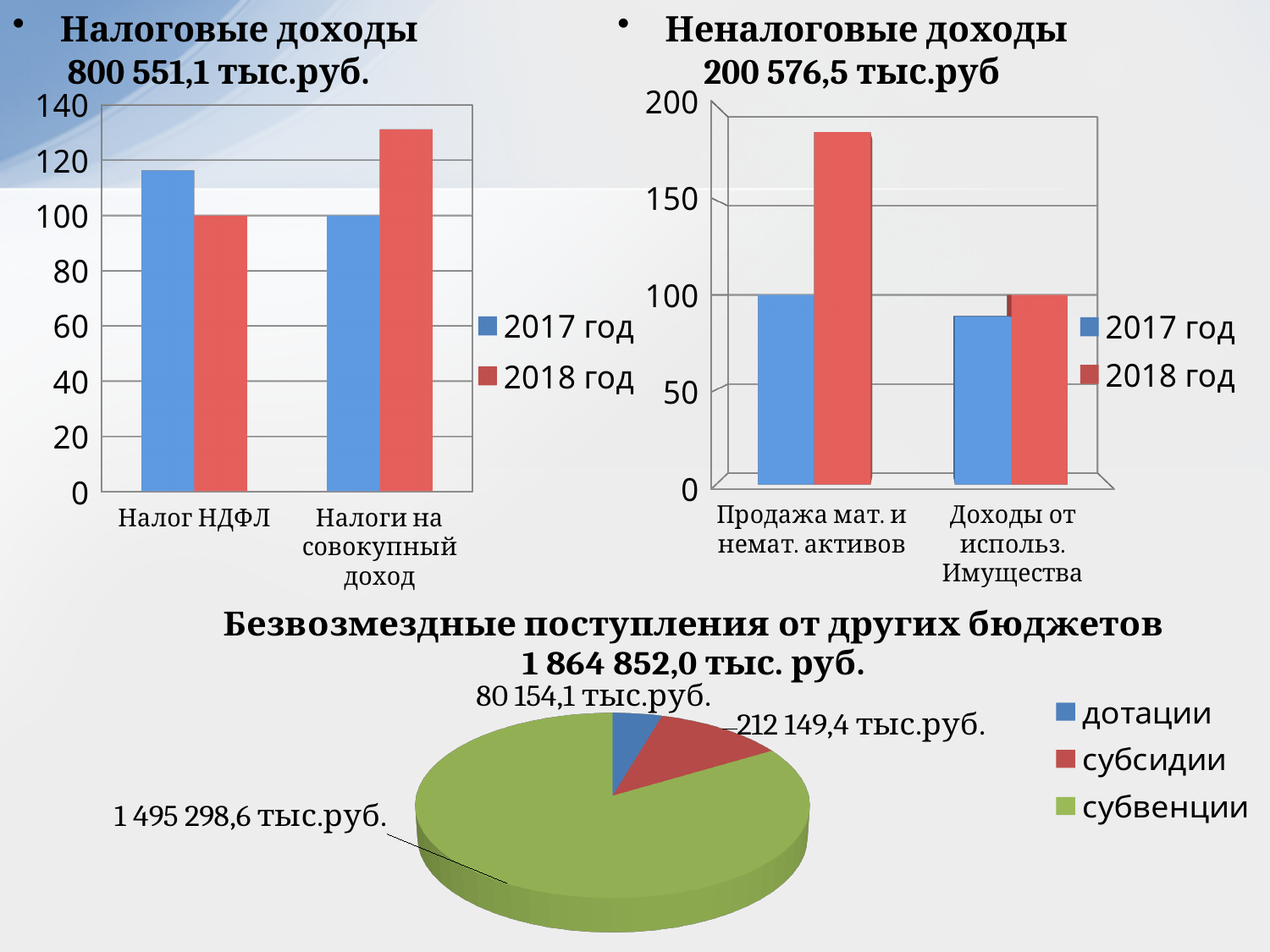
In the 'Неналоговые доходы' chart, is the value for 'Доходы от использ. Имущества' in 2017 год greater or less than 100? less In the 'Налоговые доходы' chart, what is the value for 'Налог НДФЛ' in 2018 год? 100 How many series does the legend of the 'Неналоговые доходы' chart list? 2 What type of chart is the 'Налоговые доходы' chart? bar chart In the 'Налоговые доходы' chart, which series is larger for 'Налог НДФЛ', 2017 год or 2018 год? 2017 год What type of chart is the 'Безвозмездные поступления от других бюджетов' chart? pie chart In the 'Безвозмездные поступления от других бюджетов' pie chart, what is the value for 'субсидии'? 212 149,4 тыс.руб. In the 'Налоговые доходы' chart, is the value for 'Налоги на совокупный доход' in 2018 год greater or less than 120? greater In the 'Безвозмездные поступления от других бюджетов' pie chart, what is the difference between the 'субсидии' and 'дотации' values? 131 995,3 тыс.руб. In the 'Неналоговые доходы' chart, is the value for 'Продажа мат. и немат. активов' in 2018 год greater or less than 150? greater In the 'Неналоговые доходы' chart, which category has the highest bar? Продажа мат. и немат. активов In the 'Безвозмездные поступления от других бюджетов' pie chart, which slice is the smallest? дотации